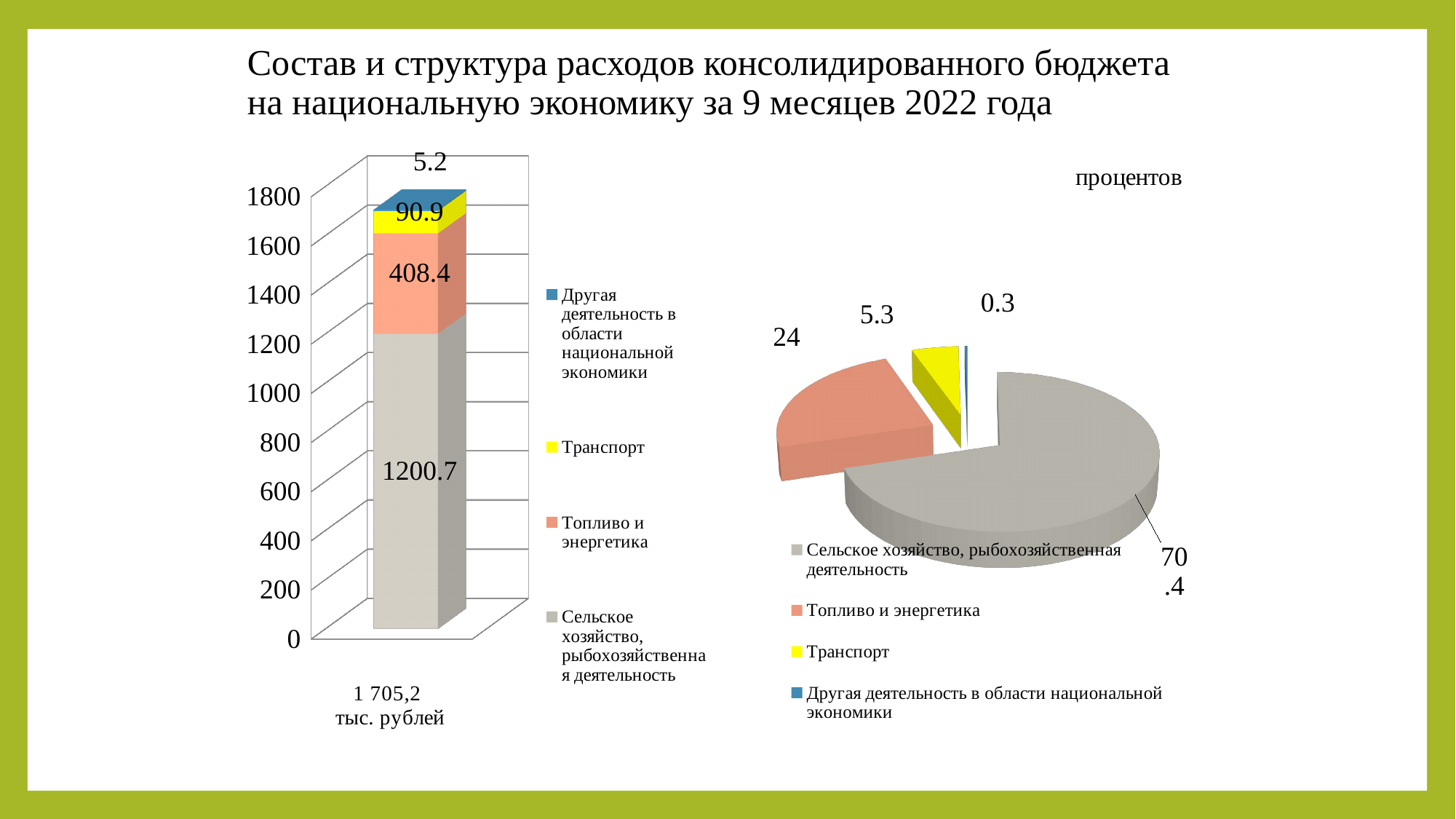
On the left bar chart, what is the value for Транспорт? 90.9 On the right pie chart, which category has the smallest slice? Другая деятельность в области национальной экономики On the left bar chart, what is the difference between the Топливо и энергетика segment and the Транспорт segment? 317.5 On the left bar chart, how many series does the legend list? 4 On the left bar chart, what is the value for Топливо и энергетика? 408.4 On the right pie chart, what is the value for Транспорт? 5.3 On the right pie chart, which is larger: Топливо и энергетика or Транспорт? Топливо и энергетика On the left bar chart, what is the value for Сельское хозяйство, рыбохозяйственная деятельность? 1200.7 What kind of chart is the chart on the left of the slide? Stacked bar chart On the left bar chart, which series has the largest segment? Сельское хозяйство, рыбохозяйственная деятельность On the left bar chart, what is the value for Другая деятельность в области национальной экономики? 5.2 On the right pie chart, what share does Сельское хозяйство, рыбохозяйственная деятельность have? 70.4